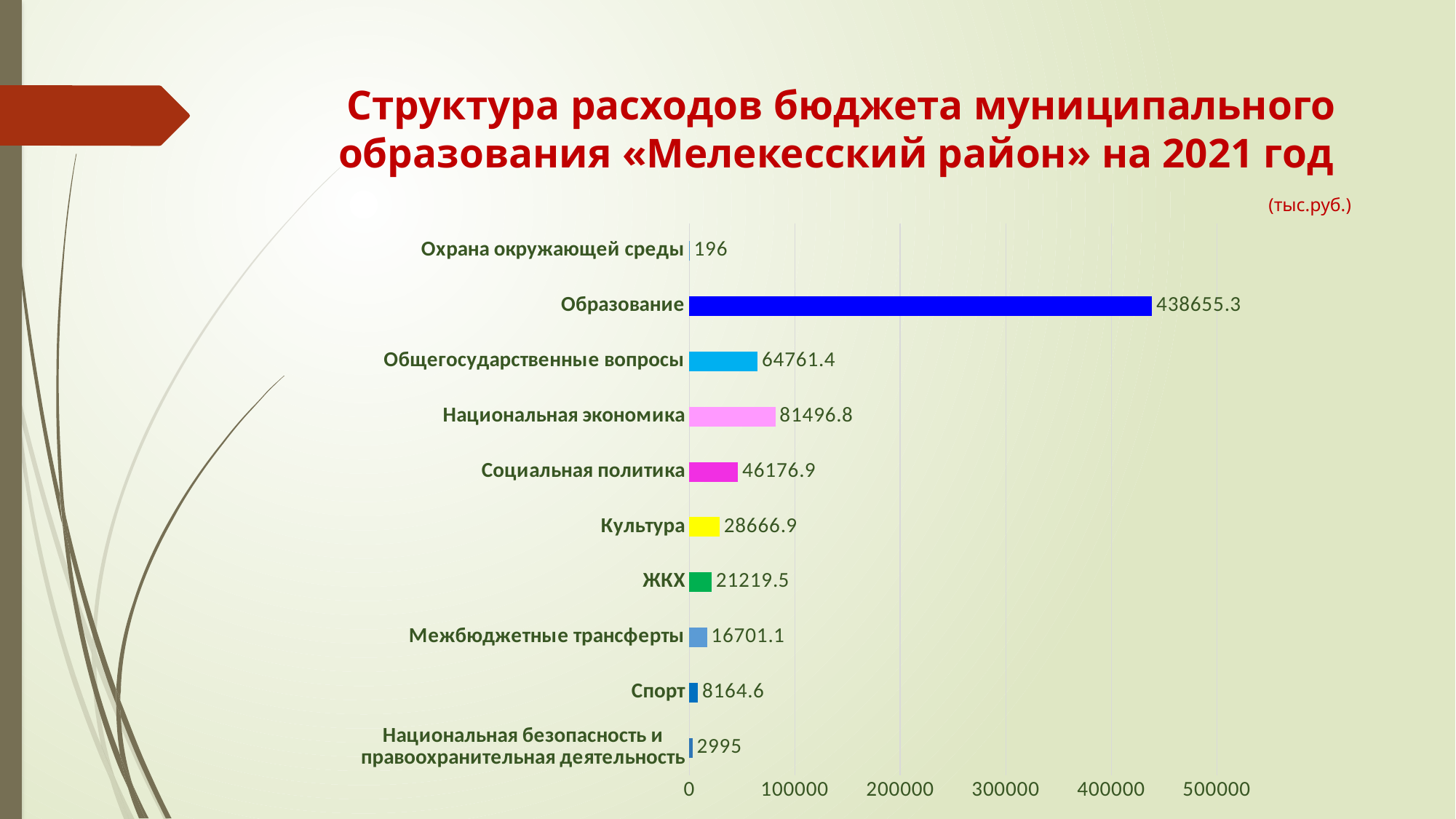
What is the value for Социальная политика? 46176.9 What is the difference between the values for Культура and ЖКХ? 7447.4 Which category has the highest value? Образование What is the value for Межбюджетные трансферты? 16701.1 Is the value for Образование greater or less than 400000? greater What is the value for Охрана окружающей среды? 196 How many categories are shown in the chart? 10 Which category has the lowest value? Охрана окружающей среды What is the value for Образование? 438655.3 What is the difference between the values for Национальная экономика and Общегосударственные вопросы? 16735.4 What kind of chart is shown on the slide? bar chart Which is larger, the value for Спорт or the value for Национальная безопасность и правоохранительная деятельность? Спорт